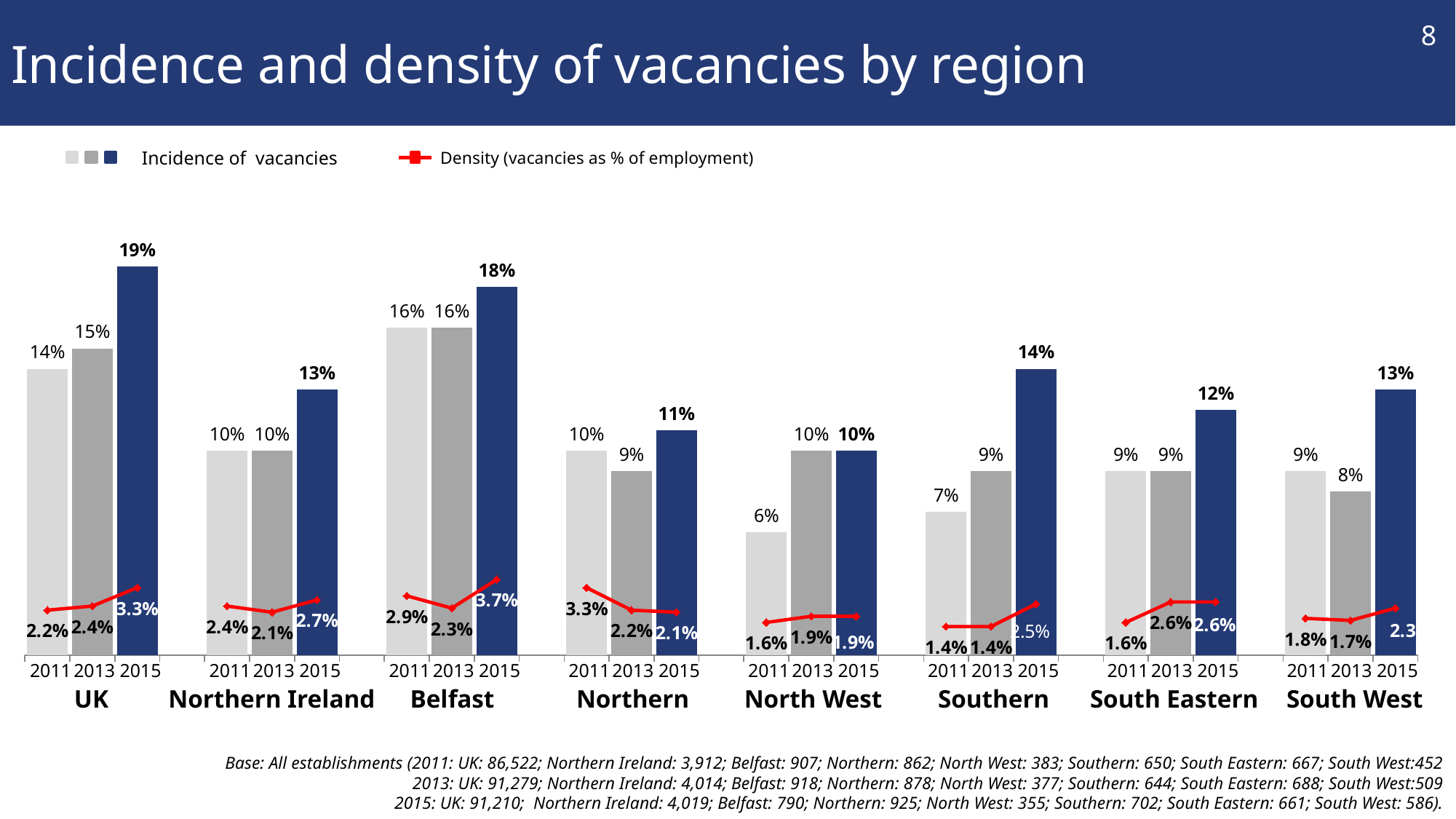
How does the incidence of vacancies for Southern change from 2011 to 2015? It rises How does the density of vacancies for Northern change from 2011 to 2015? It falls Which region has the lowest incidence of vacancies in 2011? North West What is the difference between the 2015 and 2011 incidence of vacancies for Southern? 7% How many regions are shown on the chart? 8 Which is larger, the 2015 incidence of vacancies for Belfast or for Northern Ireland? Belfast What is the incidence of vacancies for North West in 2011? 6% What is the density of vacancies for Belfast in 2015? 3.7% What does the red line on the chart represent? Density (vacancies as % of employment) What kind of chart is used to show the incidence of vacancies? Bar chart Which region has the highest incidence of vacancies in 2015? UK What is the incidence of vacancies for the UK in 2015? 19%